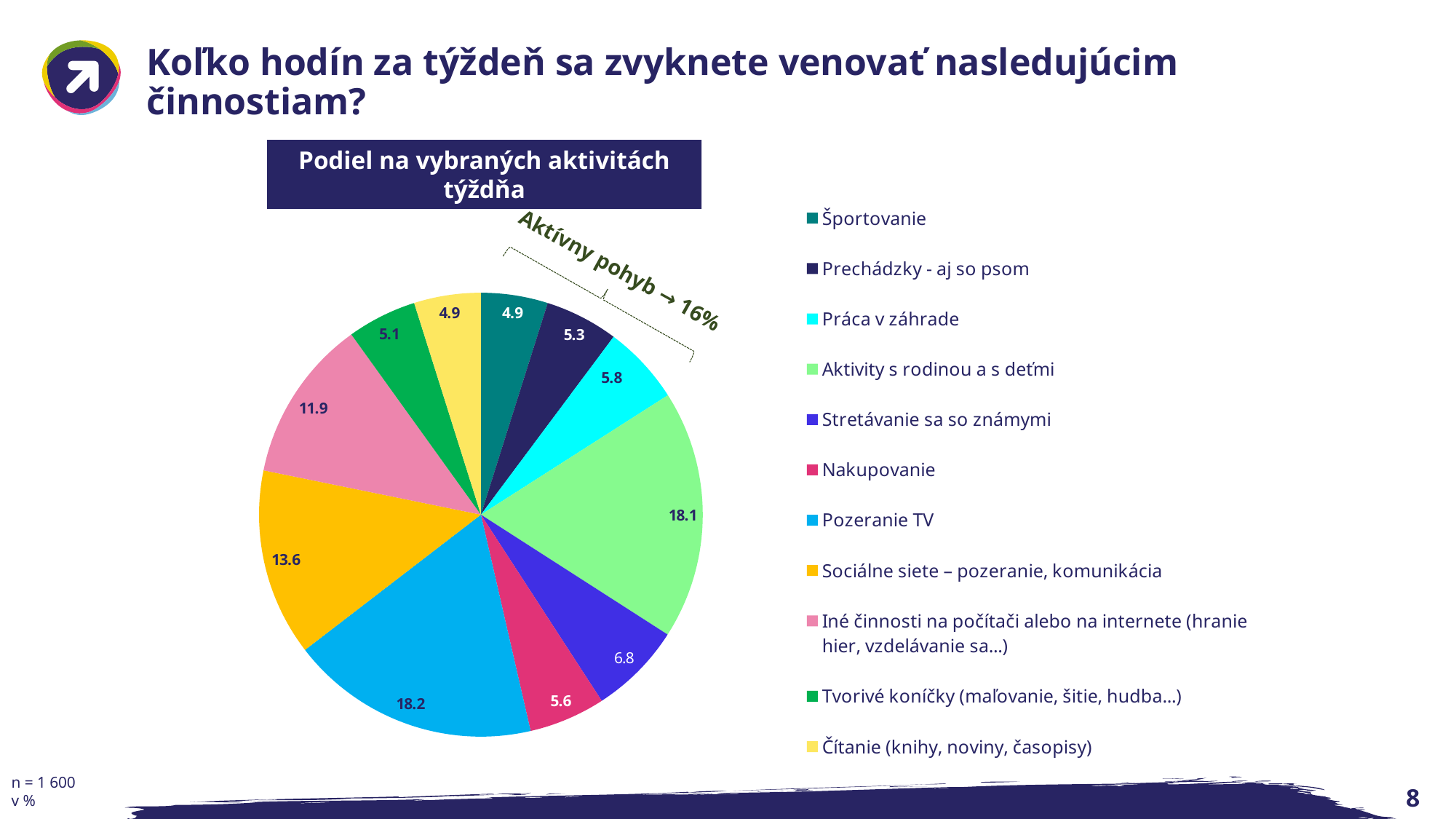
What is the value for Pozeranie TV? 18.2 How many categories does the legend list? 11 What is the value for Aktivity s rodinou a s deťmi? 18.1 What percentage does the annotation 'Aktívny pohyb' give for the grouped slices? 16% What is the difference between the values for Pozeranie TV and Sociálne siete – pozeranie, komunikácia? 4.6 Which category has the largest slice of the pie? Pozeranie TV What kind of chart is shown on the slide? pie chart What is the value for Sociálne siete – pozeranie, komunikácia? 13.6 What is the value for Práca v záhrade? 5.8 What is the value for Nakupovanie? 5.6 Which is larger, the value for Stretávanie sa so známymi or the value for Prechádzky - aj so psom? Stretávanie sa so známymi What is the title shown above the pie chart? Podiel na vybraných aktivitách týždňa